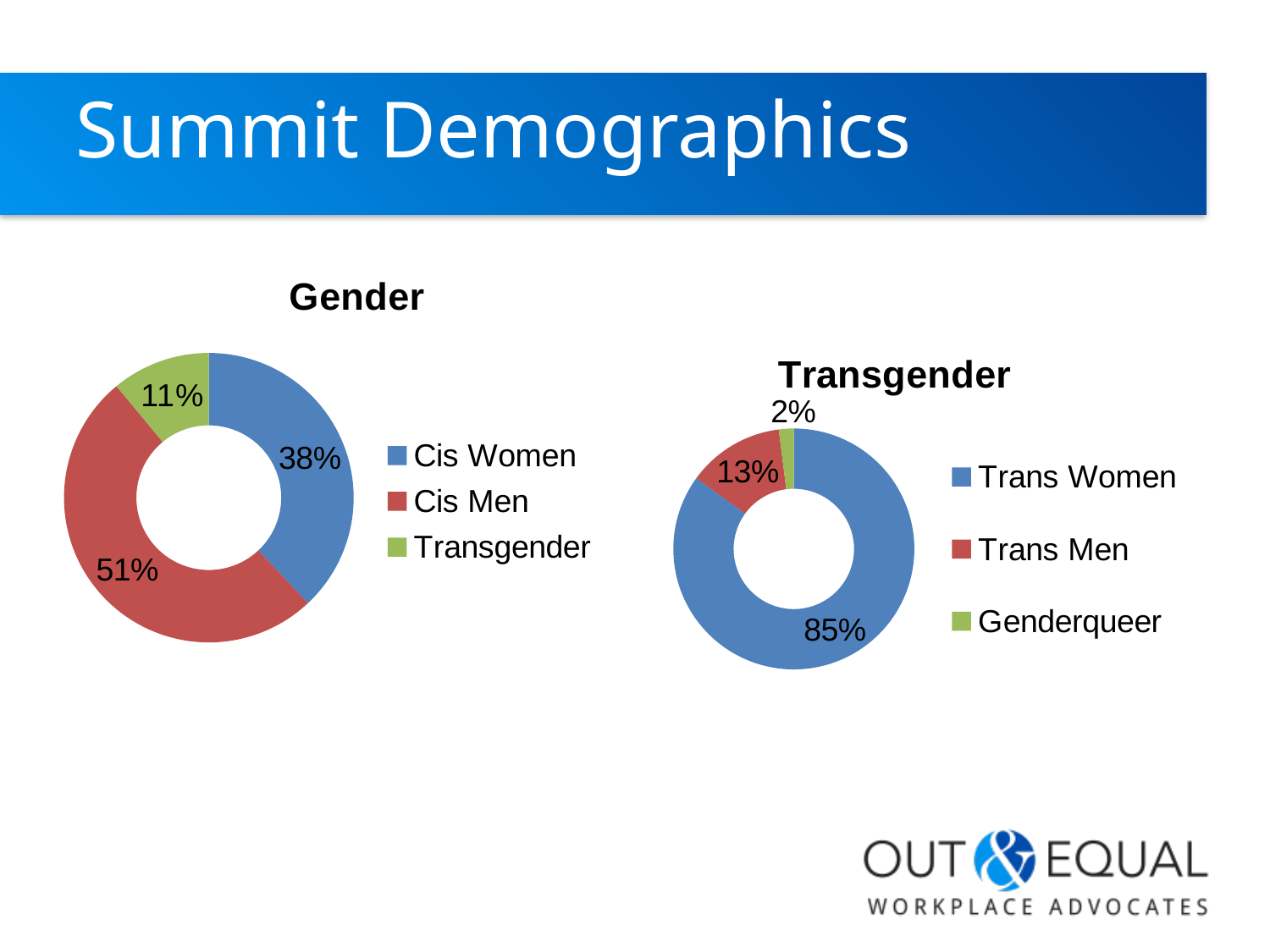
In the Transgender chart, what share is Genderqueer? 2% In the Gender chart, what share is Cis Men? 51% In the Transgender chart, which is larger, Trans Men or Genderqueer? Trans Men In the Gender chart, which category has the largest share? Cis Men In the Gender chart, what share is Transgender? 11% In the Transgender chart, what share is Trans Men? 13% In the Gender chart, what is the difference in percentage points between Cis Men and Cis Women? 13 In the Gender chart, what share is Cis Women? 38% In the Transgender chart, what share is Trans Women? 85% In the Gender chart, which category has the smallest share? Transgender How many categories does the legend of the Transgender chart list? 3 What kind of chart is the Gender chart? Doughnut (pie) chart